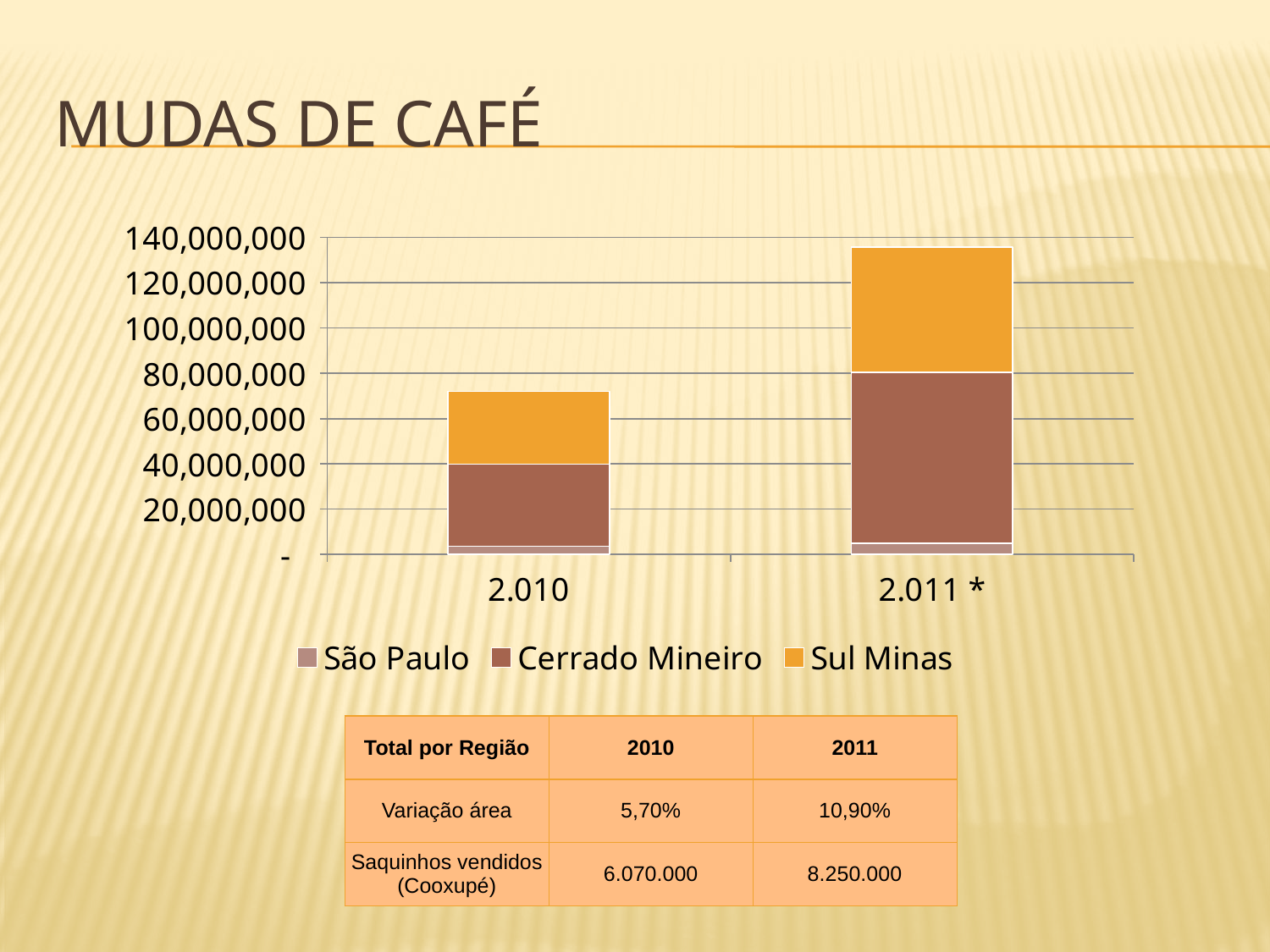
What kind of chart is shown on the slide? Stacked bar chart Is the total of the stacked bar for 2.011 * greater or less than 120,000,000? greater How many categories are shown on the x axis of the chart? 2 What is the title of the slide containing the chart? MUDAS DE CAFÉ Which series forms the smallest segment in both stacked bars? São Paulo Which series forms the largest segment of the 2.011 * bar? Cerrado Mineiro Do the stacked bar totals rise or fall from 2.010 to 2.011 *? rise Is the total of the stacked bar for 2.010 greater or less than 60,000,000? greater Which series is shown in orange in the chart legend? Sul Minas How many series does the chart legend list? 3 Which category has the taller stacked bar, 2.010 or 2.011 *? 2.011 * Is the total of the stacked bar for 2.010 greater or less than 80,000,000? less